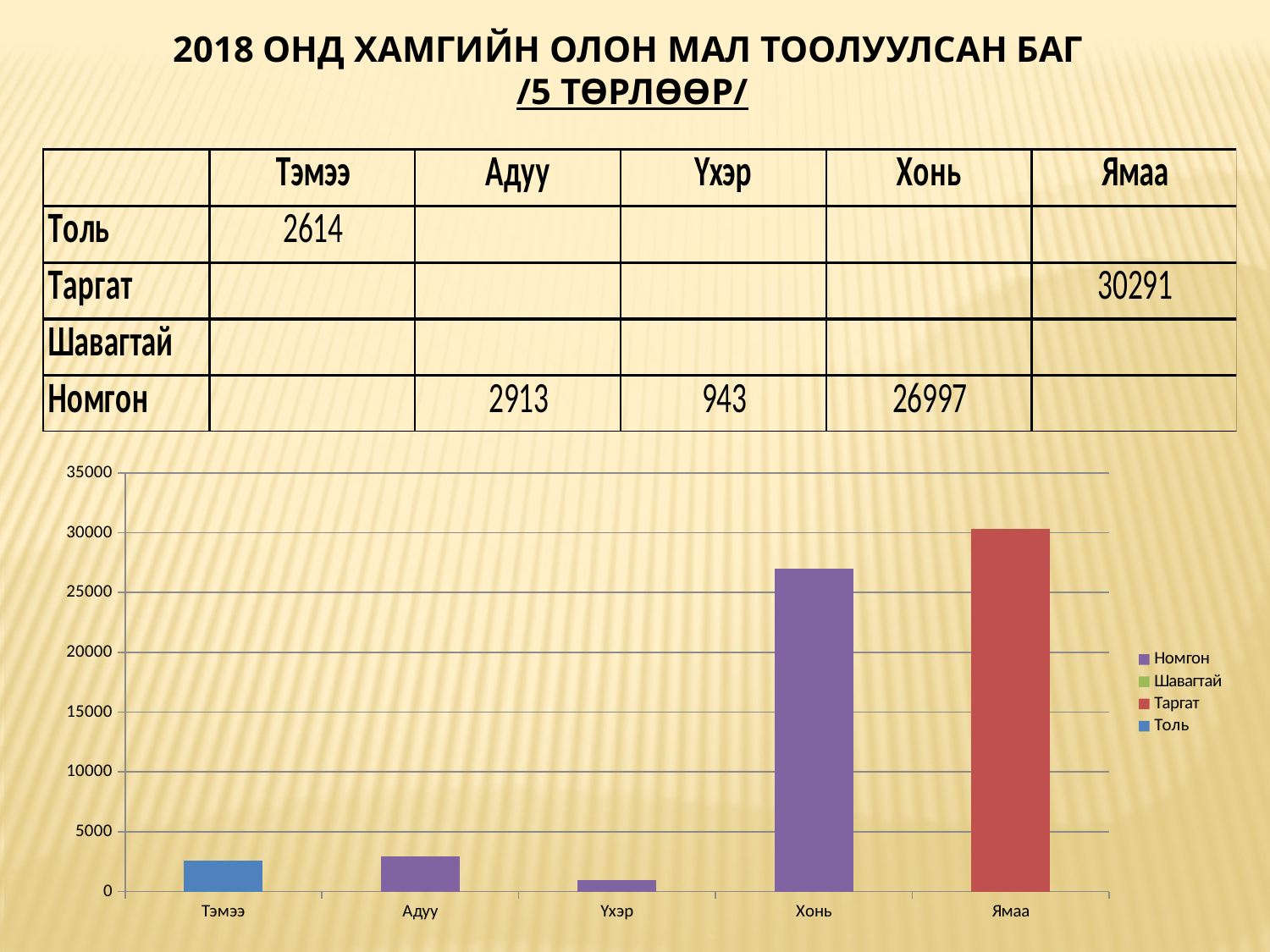
Is the value for Адуу greater or less than 5000? less Which category has the shortest bar in the chart? Үхэр Is the value for Хонь greater or less than 25000? greater What kind of chart is shown on the slide? bar chart Using the values in the table, what is the difference between Ямаа (30291) and Хонь (26997)? 3294 According to the table, what is the value for Ямаа (Таргат)? 30291 Which category has the tallest bar in the chart? Ямаа According to the table, what is the value for Хонь (Номгон)? 26997 How many series does the chart legend list? 4 How many livestock categories are shown on the x axis of the chart? 5 Which bar is taller, Хонь or Ямаа? Ямаа Which series does the red bar for Ямаа belong to, according to the legend? Таргат